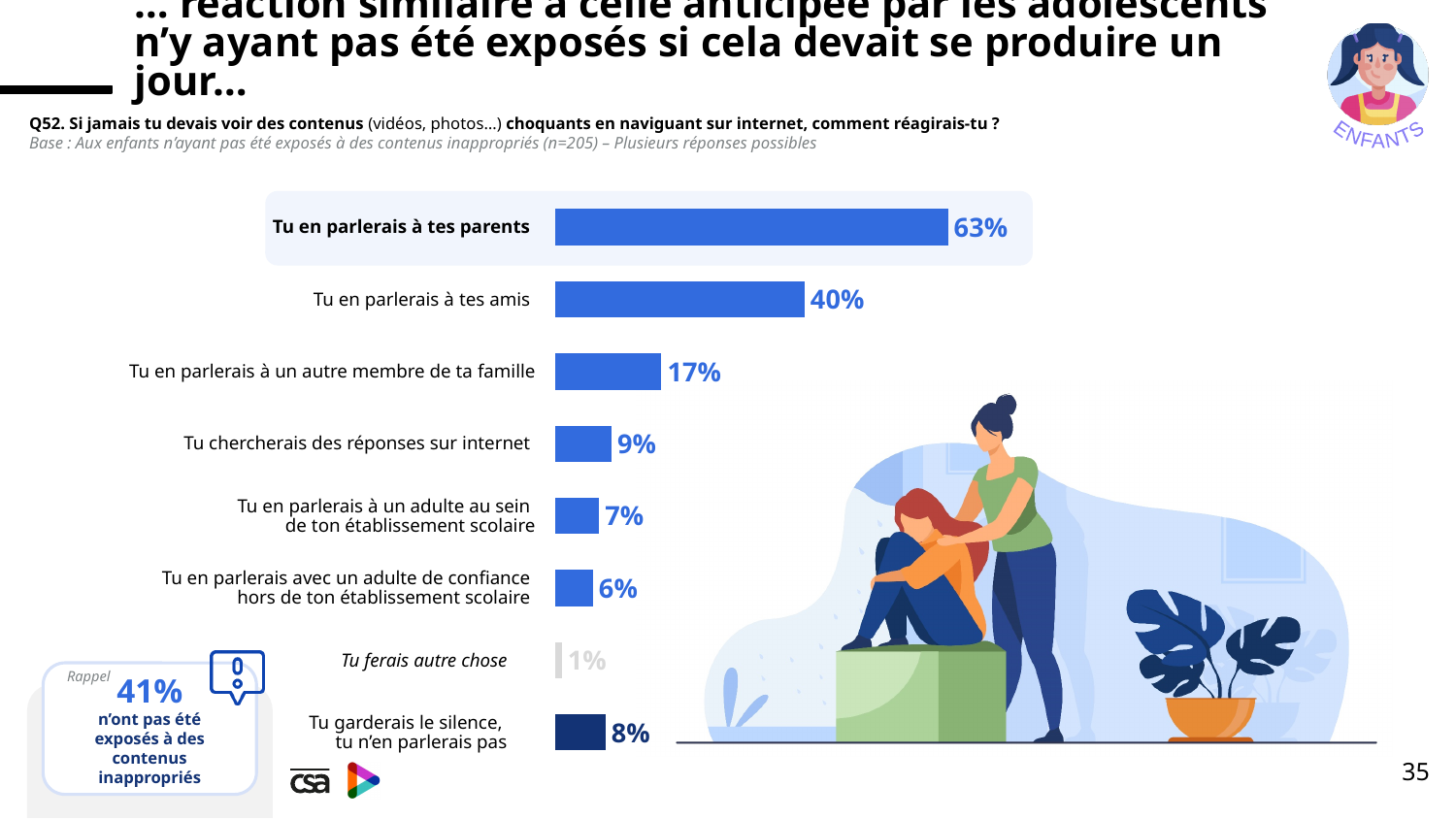
What is the difference between "Tu en parlerais à tes parents" and "Tu en parlerais à tes amis"? 23 percentage points Which response has the highest percentage? Tu en parlerais à tes parents What is the value for "Tu garderais le silence, tu n'en parlerais pas"? 8% Which is larger: "Tu en parlerais à un adulte au sein de ton établissement scolaire" or "Tu en parlerais avec un adulte de confiance hors de ton établissement scolaire"? Tu en parlerais à un adulte au sein de ton établissement scolaire What is the value for "Tu en parlerais à un autre membre de ta famille"? 17% What is the value for "Tu chercherais des réponses sur internet"? 9% What type of chart is shown on the slide? Bar chart How many response categories are shown in the chart? 8 Which response has the lowest percentage? Tu ferais autre chose What is the sample size (n) given in the base note of the chart? n=205 What percentage of respondents said they would talk to their parents ("Tu en parlerais à tes parents")? 63% What is the value for "Tu en parlerais à tes amis"? 40%